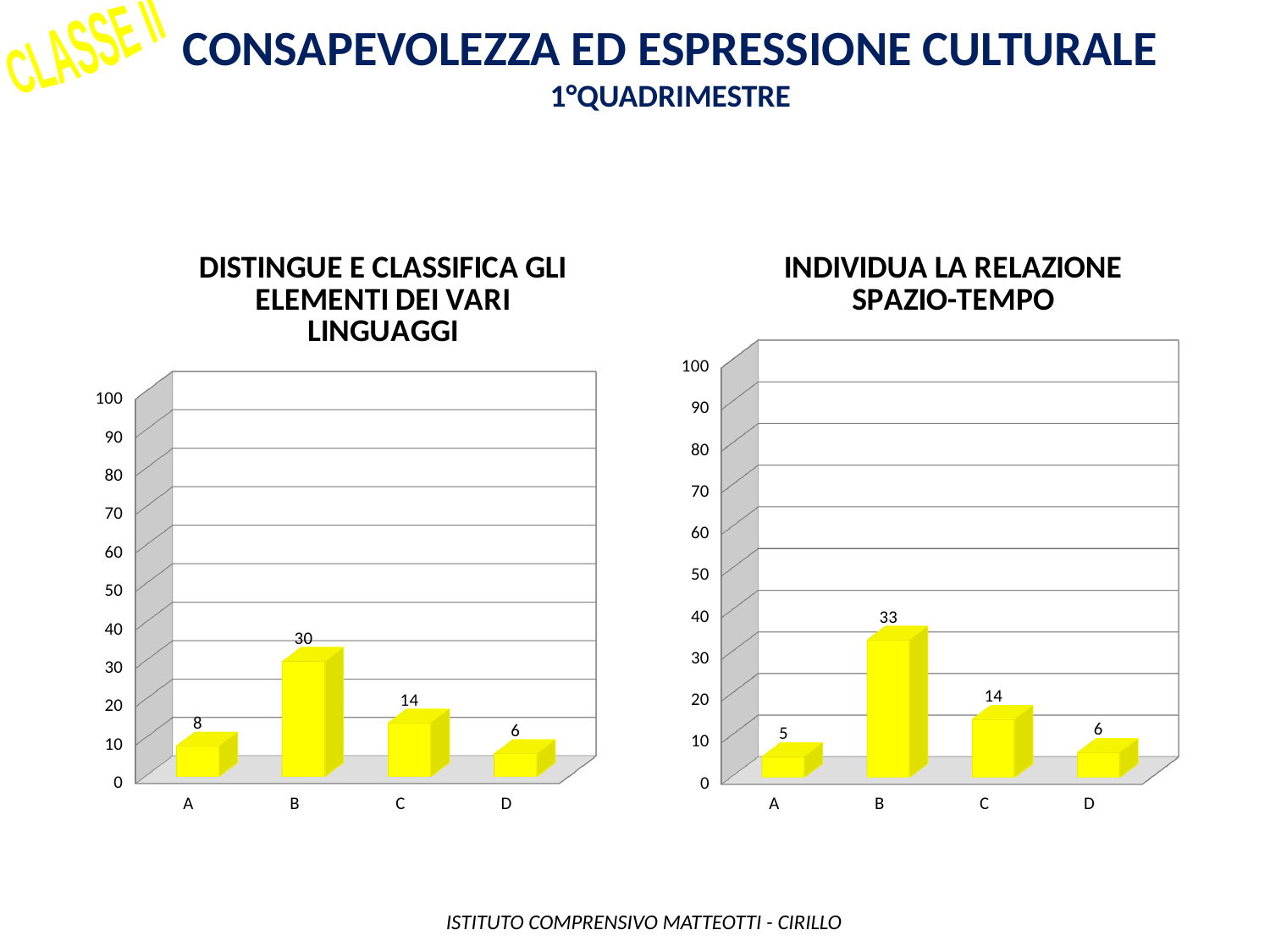
In the chart titled 'INDIVIDUA LA RELAZIONE SPAZIO-TEMPO', what is the difference between the values for B and A? 28 What colour are the bars in the chart titled 'DISTINGUE E CLASSIFICA GLI ELEMENTI DEI VARI LINGUAGGI'? Yellow In the chart titled 'DISTINGUE E CLASSIFICA GLI ELEMENTI DEI VARI LINGUAGGI', what is the difference between the values for B and C? 16 How many categories are shown in the chart titled 'INDIVIDUA LA RELAZIONE SPAZIO-TEMPO'? 4 In the chart titled 'DISTINGUE E CLASSIFICA GLI ELEMENTI DEI VARI LINGUAGGI', what is the value for category B? 30 What kind of chart is the chart titled 'DISTINGUE E CLASSIFICA GLI ELEMENTI DEI VARI LINGUAGGI'? Bar chart In the chart titled 'DISTINGUE E CLASSIFICA GLI ELEMENTI DEI VARI LINGUAGGI', is the value for B greater or less than 20? greater In the chart titled 'DISTINGUE E CLASSIFICA GLI ELEMENTI DEI VARI LINGUAGGI', which category has the lowest value? D In the chart titled 'INDIVIDUA LA RELAZIONE SPAZIO-TEMPO', what is the value for category A? 5 In the chart titled 'INDIVIDUA LA RELAZIONE SPAZIO-TEMPO', which category has the highest value? B In the chart titled 'INDIVIDUA LA RELAZIONE SPAZIO-TEMPO', which is larger, the value for C or the value for D? C In the chart titled 'INDIVIDUA LA RELAZIONE SPAZIO-TEMPO', what is the total of the values for all four categories? 58